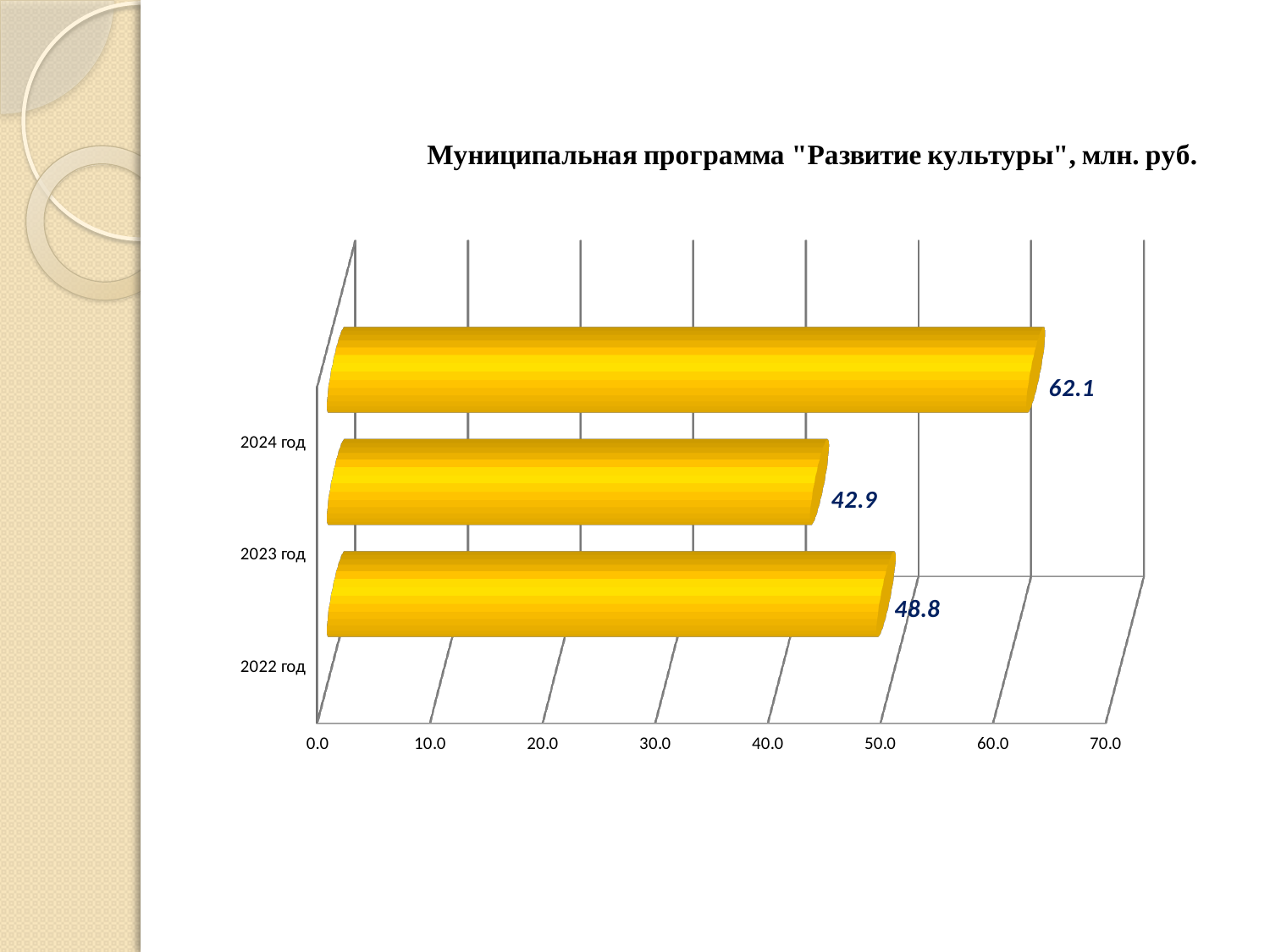
Which year has the highest value? 2024 год What is the value for 2024 год? 62.1 What is the value for 2023 год? 42.9 What is the difference between the values for 2024 год and 2023 год? 19.2 Which year has the lowest value? 2023 год How many years are shown in the chart? 3 What kind of chart is shown on the slide? bar chart Is the value for 2024 год greater or less than 60.0? greater Which is larger, the value for 2022 год or the value for 2023 год? 2022 год What is the value for 2022 год? 48.8 What is the title of the chart? Муниципальная программа "Развитие культуры", млн. руб. What is the difference between the values for 2022 год and 2023 год? 5.9